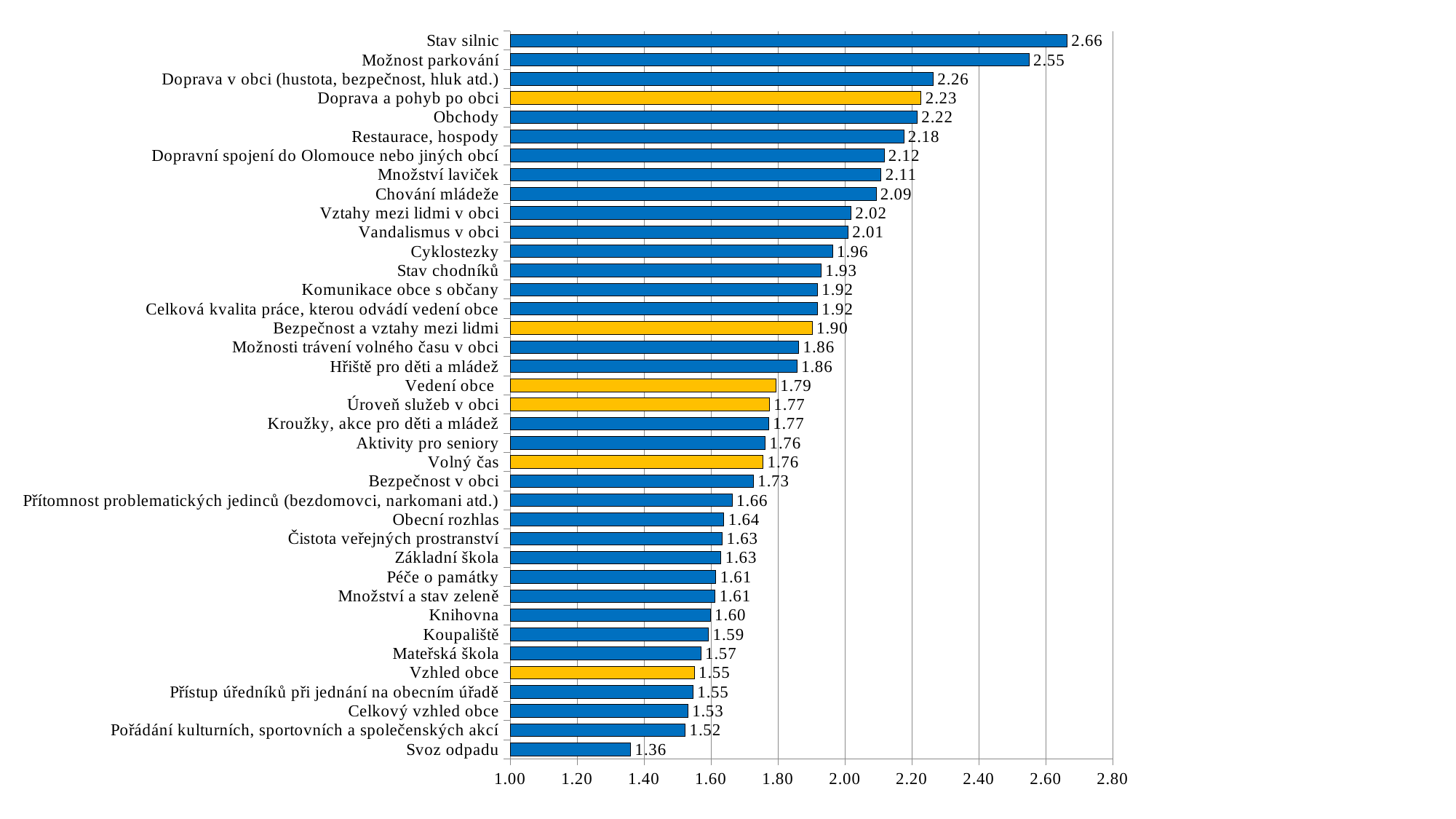
What is the value for Vedení obce? 1.79 What is the difference between the values for Stav silnic and Možnost parkování? 0.11 Is the value for Chování mládeže greater or less than 2.00? greater How many bars are coloured orange rather than blue? 6 What is the value for Svoz odpadu? 1.36 Which category has the highest value? Stav silnic Which has a larger value, Obchody or Cyklostezky? Obchody Which category has the lowest value? Svoz odpadu What is the value for Stav silnic? 2.66 What is the value for Knihovna? 1.60 What kind of chart is this? Bar chart How many categories are shown in the chart? 38